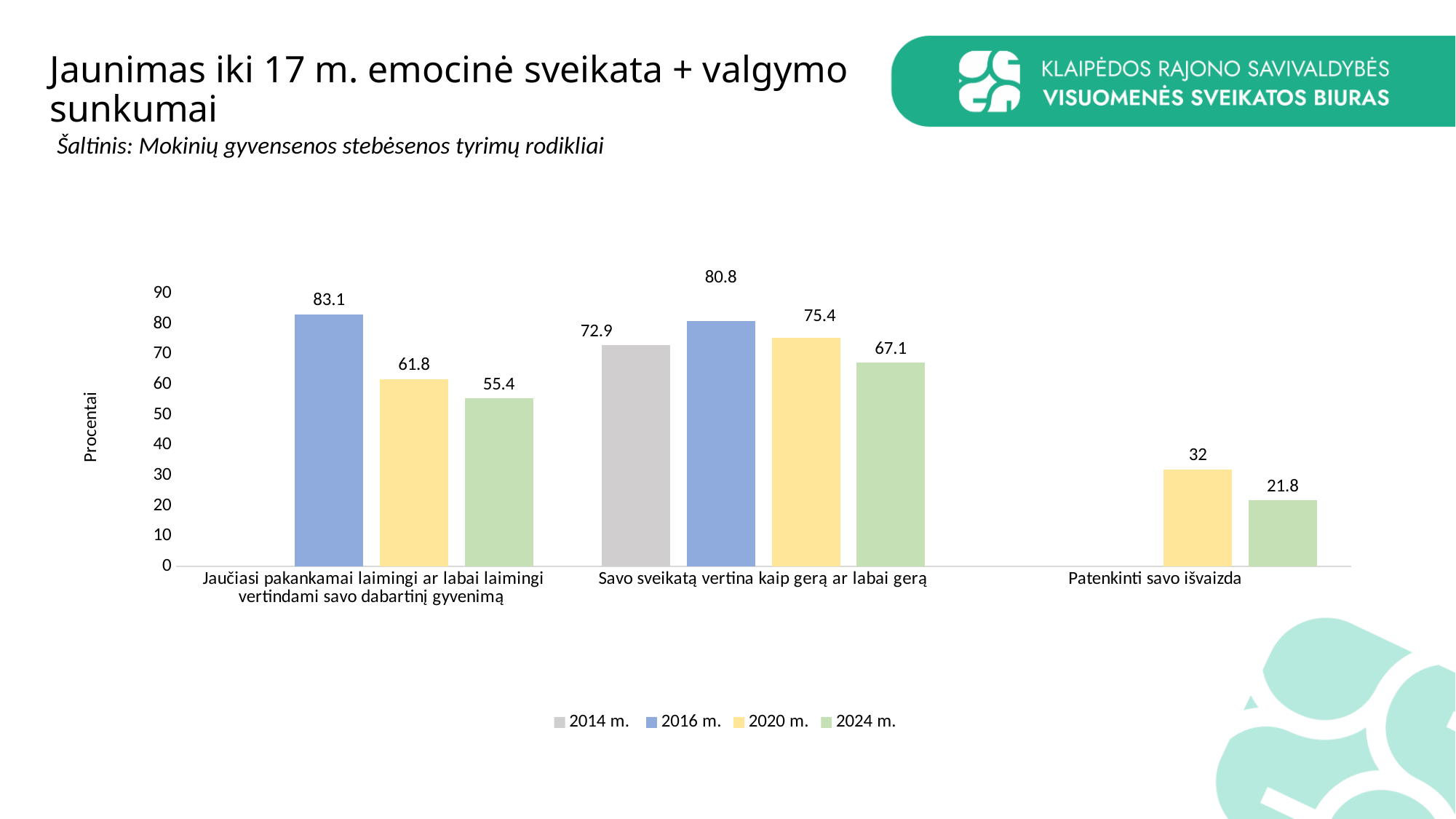
Which year has the lowest value for "Jaučiasi pakankamai laimingi ar labai laimingi vertindami savo dabartinį gyvenimą"? 2024 m. Do the values for "Savo sveikatą vertina kaip gerą ar labai gerą" rise or fall from 2016 m. to 2024 m.? Fall Which year has the highest value for "Savo sveikatą vertina kaip gerą ar labai gerą"? 2016 m. What is the 2024 m. value for "Patenkinti savo išvaizda"? 21.8 What is the 2014 m. value for "Savo sveikatą vertina kaip gerą ar labai gerą"? 72.9 Which is larger: the 2020 m. value for "Savo sveikatą vertina kaip gerą ar labai gerą" or the 2014 m. value for the same category? 2020 m. How many categories are shown on the x axis? 3 What is the difference between the 2016 m. and 2020 m. values for "Jaučiasi pakankamai laimingi ar labai laimingi vertindami savo dabartinį gyvenimą"? 21.3 What is the 2016 m. value for "Jaučiasi pakankamai laimingi ar labai laimingi vertindami savo dabartinį gyvenimą"? 83.1 How many series does the legend list? 4 What is the difference between the 2020 m. and 2024 m. values for "Patenkinti savo išvaizda"? 10.2 What kind of chart is shown on the slide? Bar chart